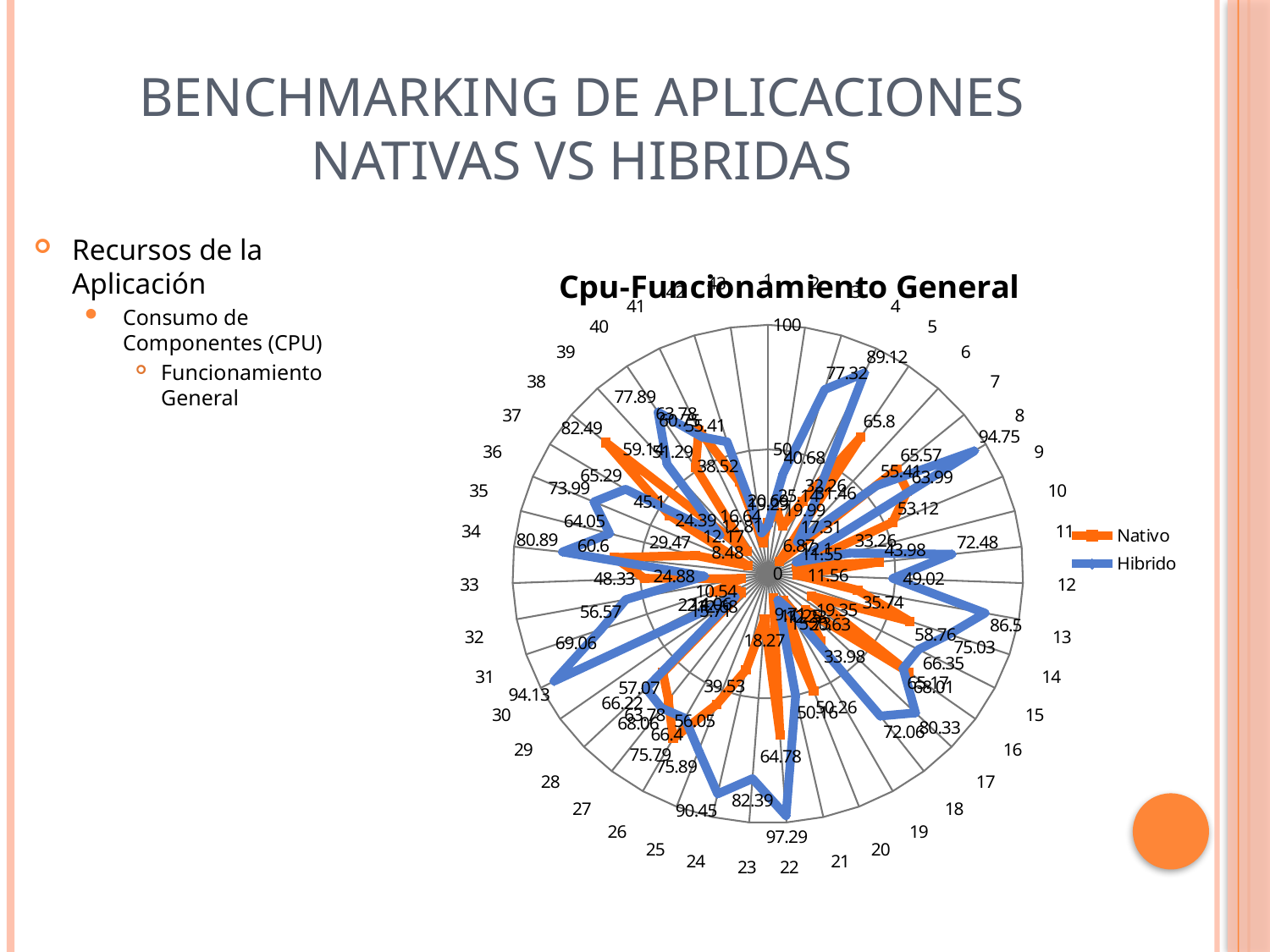
What is the Hibrido value labelled at category 31? 69.06 What are the two series named in the chart legend? Nativo and Hibrido At category 9, which series has the larger value, Nativo or Hibrido? Nativo What is the highest value labelled on the chart's radial axis? 100 How many series does the legend of the chart list? 2 Is the Hibrido value at category 5 greater or less than 50? less At category 31, which series has the larger value, Nativo or Hibrido? Hibrido Which series reaches the highest value on the chart? Hibrido What is the largest data value labelled on the chart, reached by the Hibrido series near category 22? 97.29 What is the title of the chart? Cpu-Funcionamiento General What kind of chart is shown on the slide? Radar chart